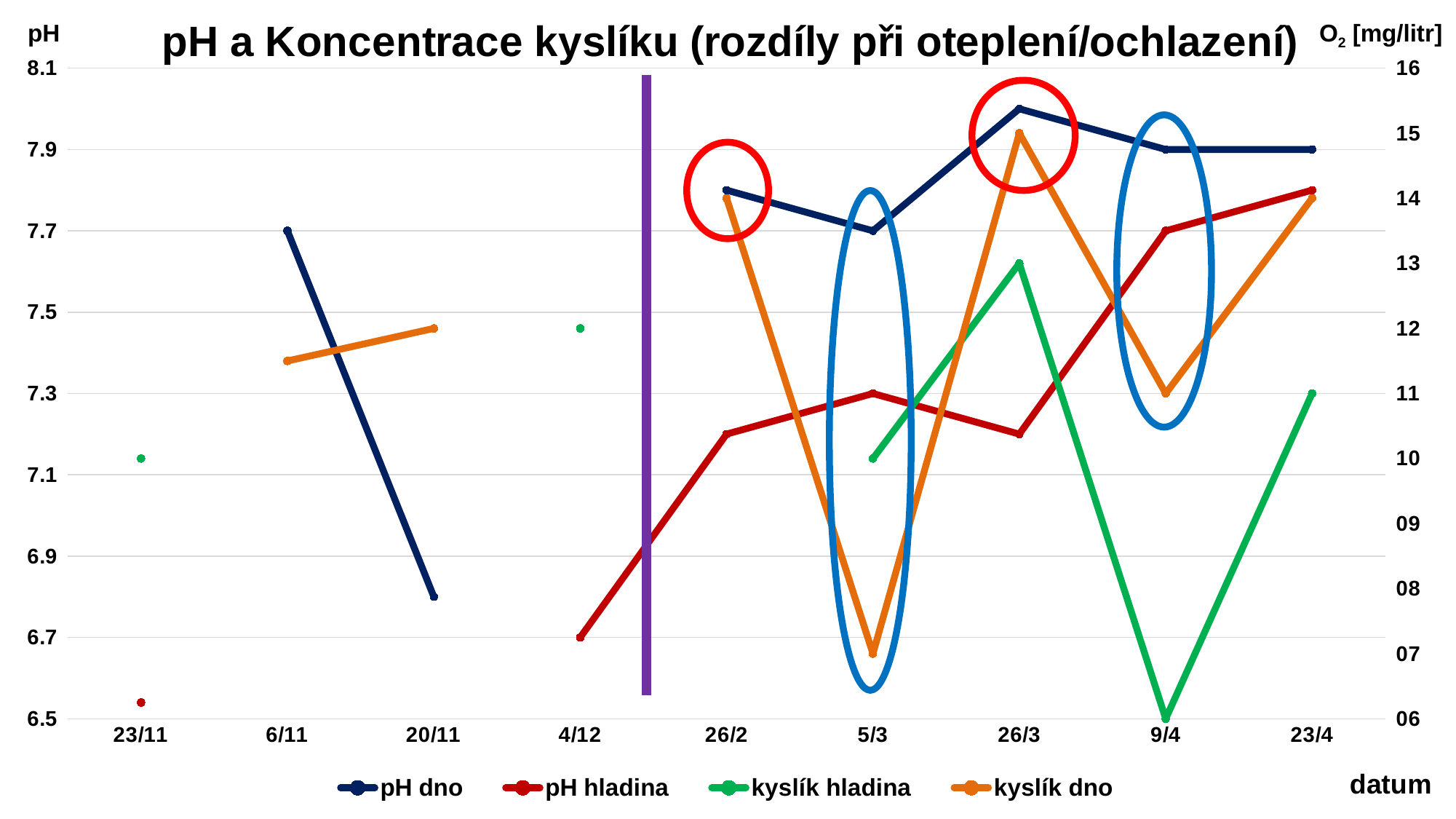
What is the title of the chart? pH a Koncentrace kyslíku (rozdíly při oteplení/ochlazení) Is the pH dno value on 20/11 greater or less than 6.9? less What is the pH hladina value on 4/12? 6.7 On which date is kyslík hladina at its lowest? 9/4 How many dates are shown on the x axis? 9 On which date is kyslík dno at its highest? 26/3 How many series does the legend list? 4 What is the pH dno value on 6/11? 7.7 What is the difference between the kyslík dno value on 26/3 and on 5/3? 8 What is the kyslík hladina value on 26/3? 13 On 5/3, which is larger: kyslík hladina or kyslík dno? kyslík hladina What kind of chart is shown on the slide? line chart